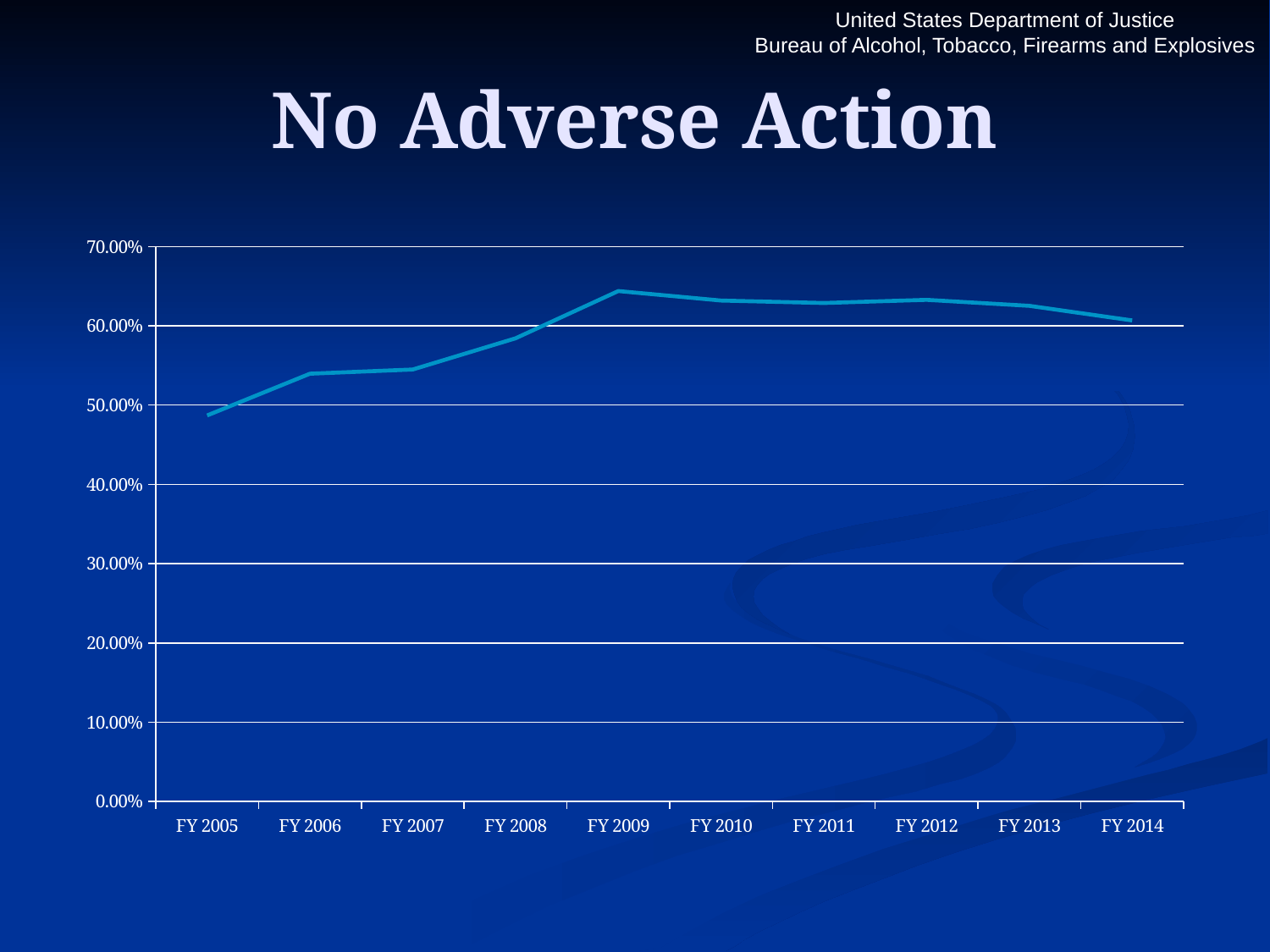
Is the value for FY 2009 greater or less than 60.00%? greater How many fiscal years are plotted on the x axis? 10 Is the value for FY 2008 greater or less than 60.00%? less Is the value for FY 2005 greater or less than 50.00%? less Which is larger, the value for FY 2005 or the value for FY 2009? FY 2009 Which fiscal year has the lowest value? FY 2005 What is the highest value shown on the y axis? 70.00% What kind of chart is shown on the slide? line chart Does the line rise or fall from FY 2005 to FY 2009? rise What is the title of the chart? No Adverse Action